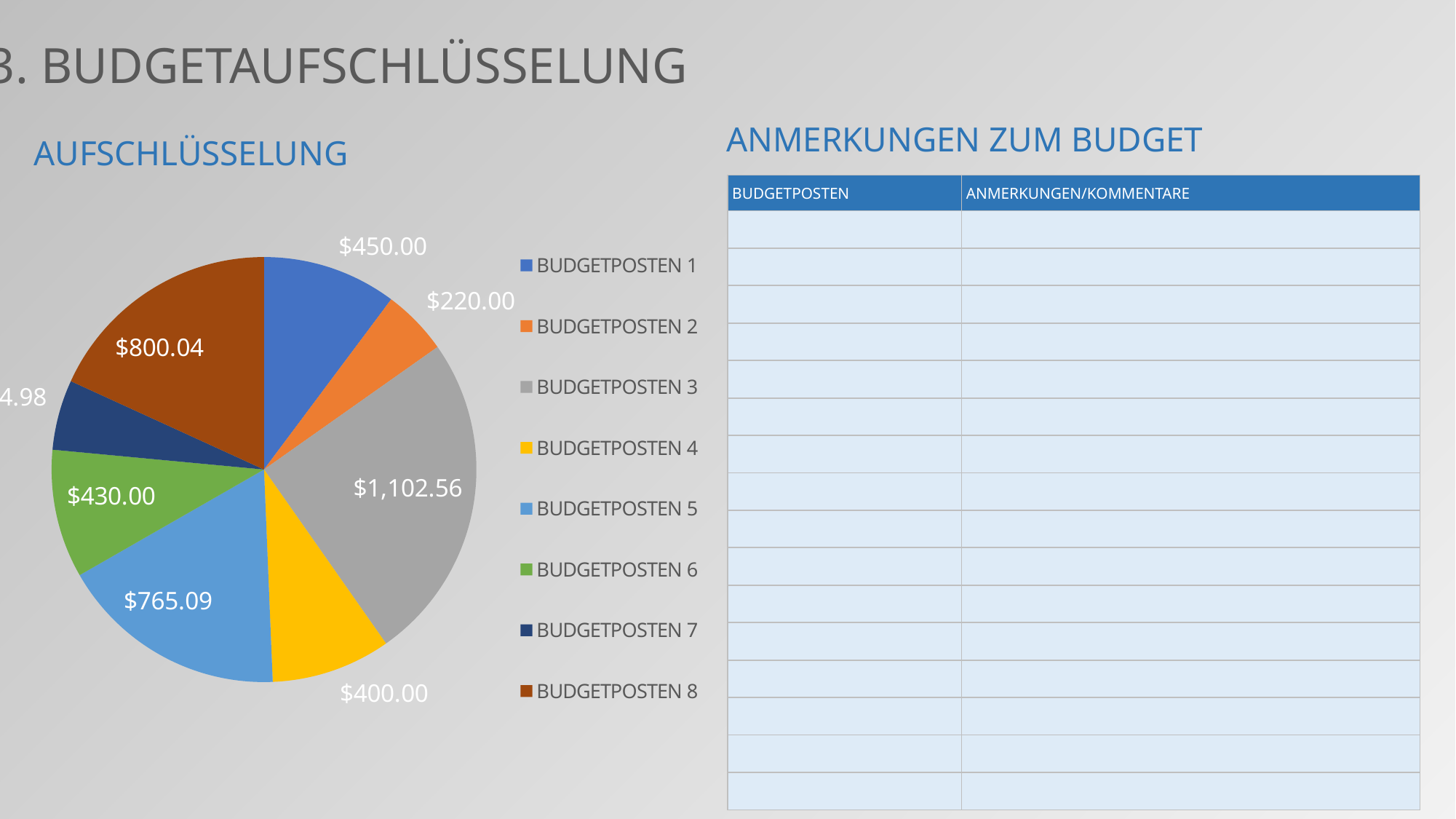
Which is larger, the value for Budgetposten 8 or the value for Budgetposten 5? Budgetposten 8 What is the value for Budgetposten 2 in the pie chart? $220.00 What is the difference between the values for Budgetposten 1 and Budgetposten 2? $230.00 What is the value for Budgetposten 1 in the pie chart? $450.00 What is the value for Budgetposten 8 in the pie chart? $800.04 What kind of chart is shown on the slide? Pie chart What is the value for Budgetposten 5 in the pie chart? $765.09 How many budget items are shown in the pie chart? 8 What colour represents Budgetposten 4 in the pie chart legend? Yellow What is the value for Budgetposten 3 in the pie chart? $1,102.56 Which budget item has the largest slice in the pie chart? Budgetposten 3 What is the difference between the values for Budgetposten 3 and Budgetposten 1? $652.56